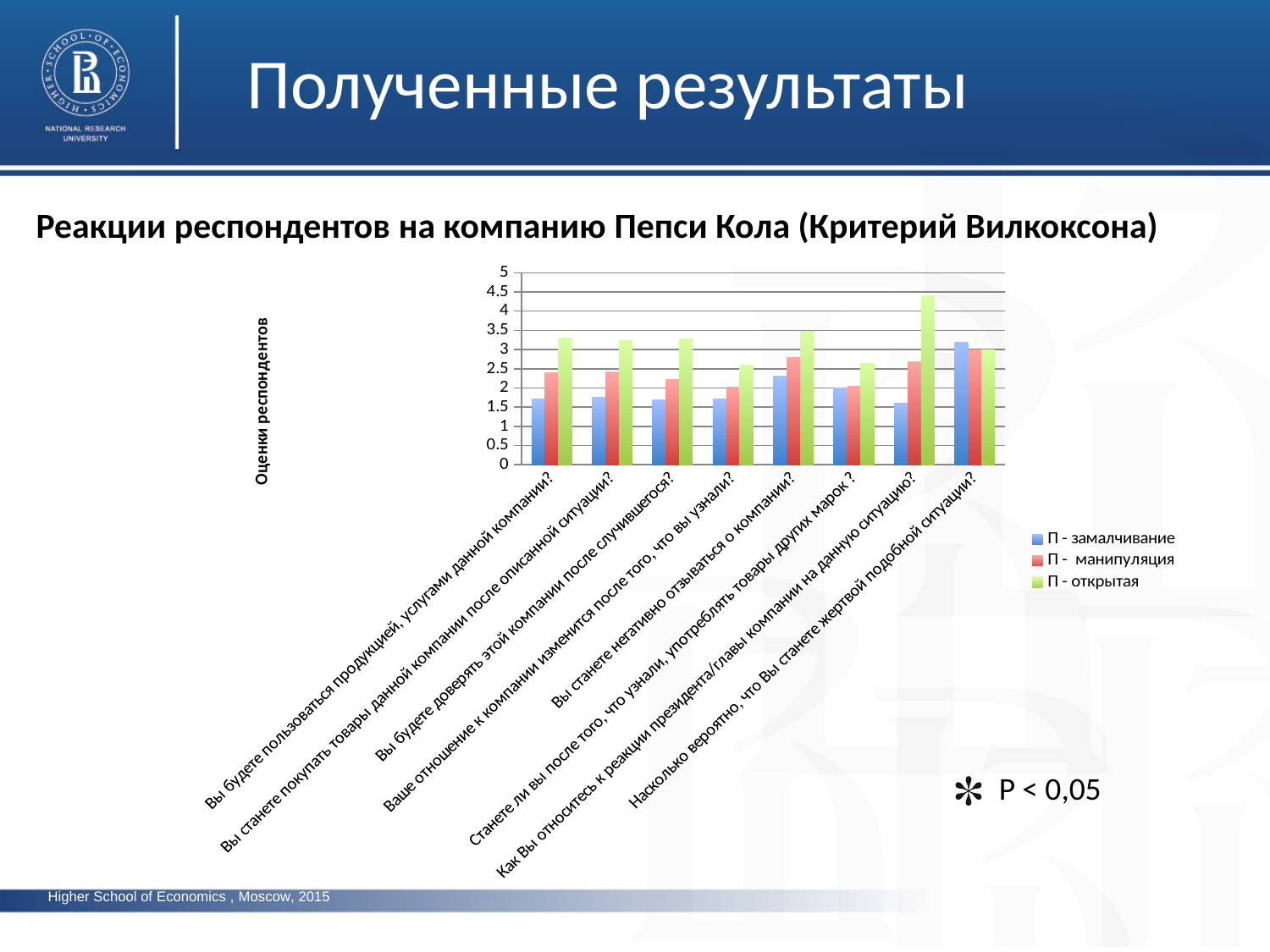
For the category "Как Вы относитесь к реакции президента/главы компании на данную ситуацию?", which series has the highest value? П - открытая Is the value of "П - замалчивание" for "Вы будете пользоваться продукцией, услугами данной компании?" greater or less than 2? less Which category contains the tallest bar in the whole chart? Как Вы относитесь к реакции президента/главы компании на данную ситуацию? What are the three series named in the chart's legend? П - замалчивание, П - манипуляция, П - открытая What kind of chart is shown on the slide? Bar chart Is the value of "П - манипуляция" for "Вы будете пользоваться продукцией, услугами данной компании?" greater or less than 2? greater How many series does the chart's legend list? 3 For "Вы станете негативно отзываться о компании?", which is larger: the value for "П - открытая" or for "П - замалчивание"? П - открытая How many question categories are plotted along the x axis of the chart? 8 Is the value of "П - открытая" for "Как Вы относитесь к реакции президента/главы компании на данную ситуацию?" greater or less than 4? greater What is the title of the vertical axis of the chart? Оценки респондентов For the category "Вы будете доверять этой компании после случившегося?", which series has the lowest value? П - замалчивание